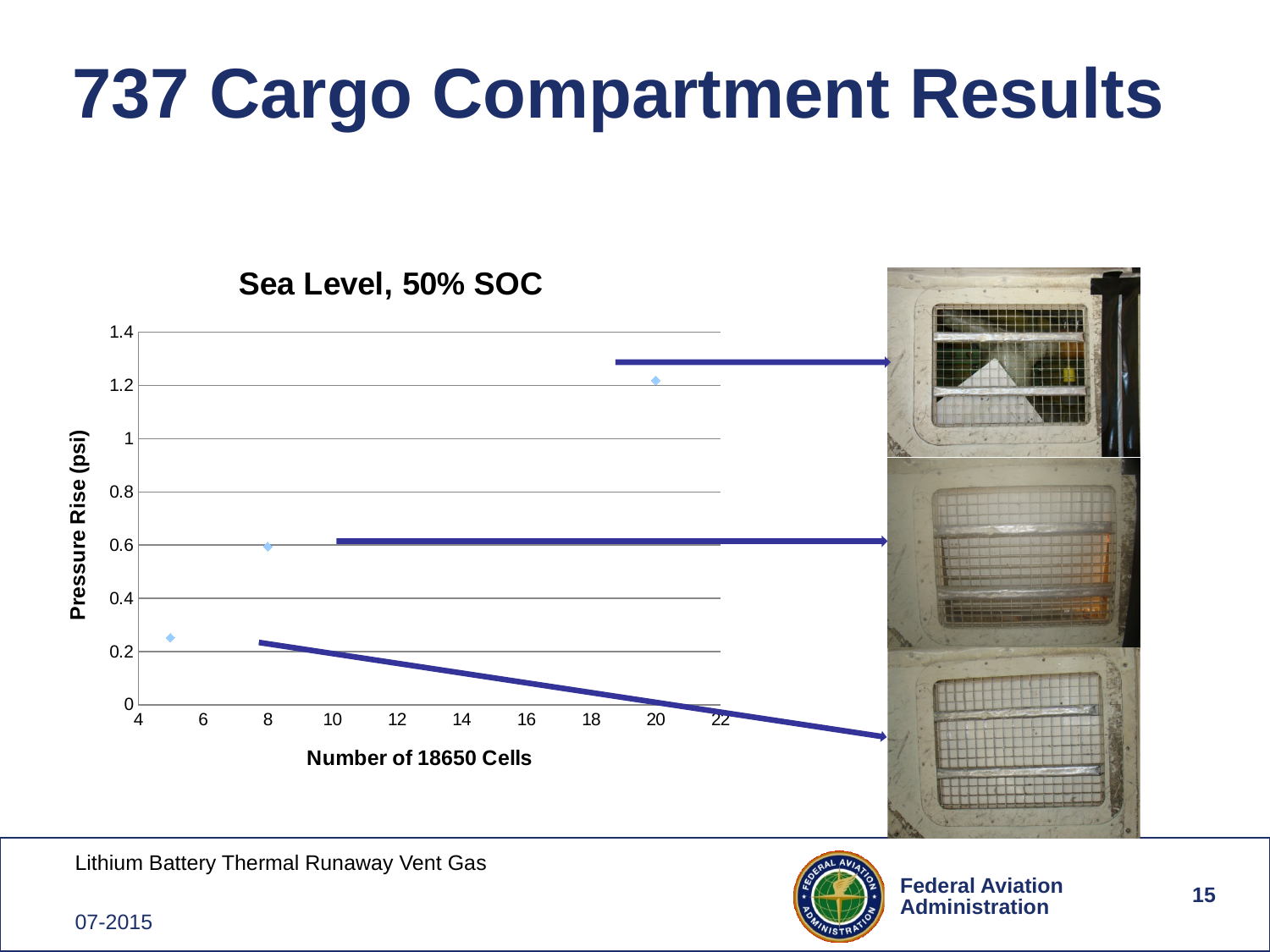
At which number of 18650 cells is the pressure rise highest? 20 How many data points are plotted on the chart? 3 Does the pressure rise increase or decrease as the number of 18650 cells increases? increase Is the pressure rise for 20 cells greater or less than 1.4 psi? less Which has a larger pressure rise, 8 cells or 20 cells? 20 cells Is the pressure rise for 5 cells greater or less than 0.4 psi? less What is the title of the chart? Sea Level, 50% SOC What is the label of the vertical axis? Pressure Rise (psi) At which number of 18650 cells is the pressure rise lowest? 5 What kind of chart is shown on the slide? scatter chart Is the pressure rise for 20 cells greater or less than 1 psi? greater